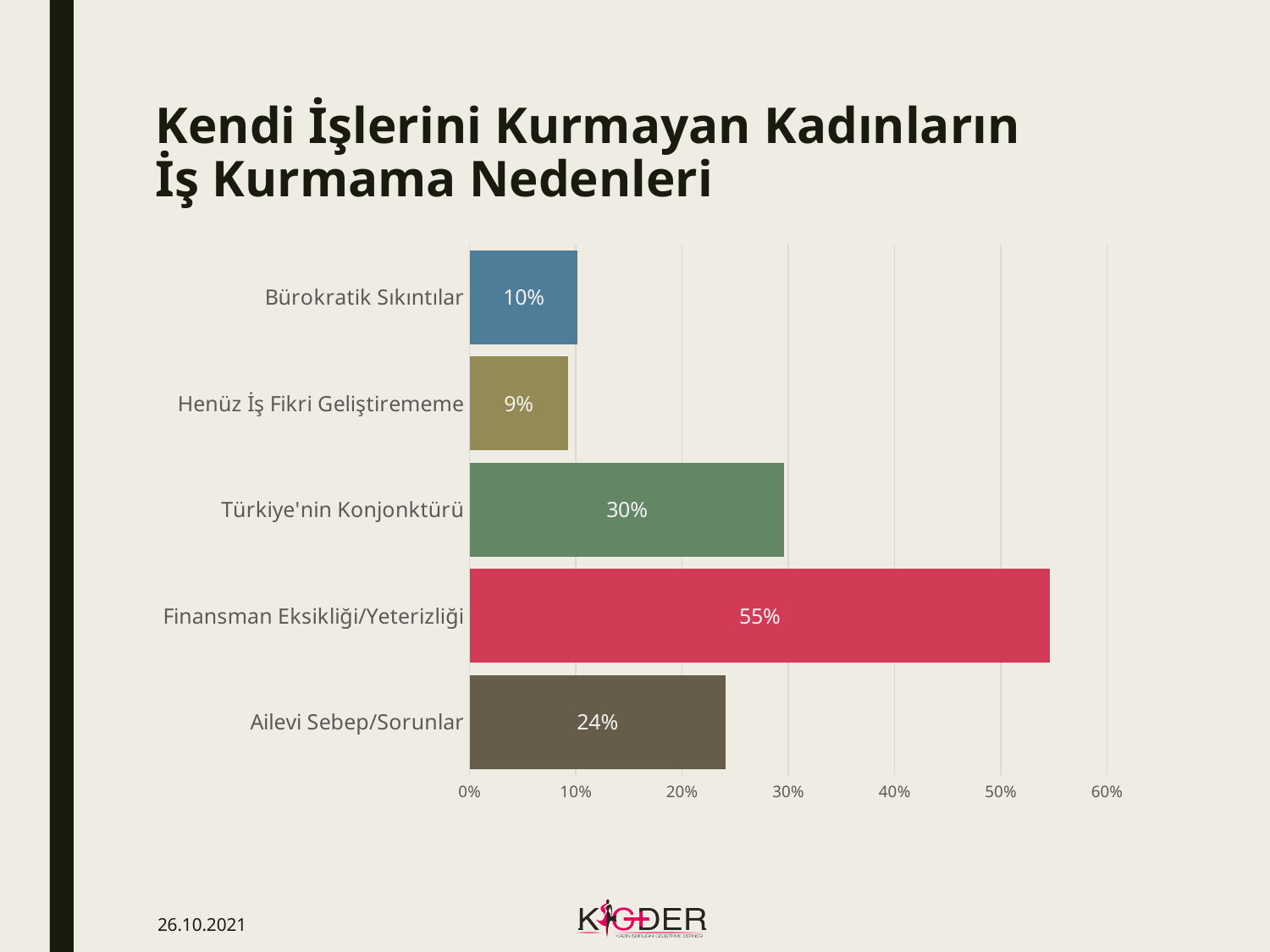
What is the difference between the values for Ailevi Sebep/Sorunlar and Bürokratik Sıkıntılar? 14% Which category has the lowest value? Henüz İş Fikri Geliştirememe Is the value for Finansman Eksikliği/Yeterizliği greater or less than 50%? greater How many categories are shown in the chart? 5 Which is larger, the value for Türkiye'nin Konjonktürü or the value for Ailevi Sebep/Sorunlar? Türkiye'nin Konjonktürü What is the title of the chart on the slide? Kendi İşlerini Kurmayan Kadınların İş Kurmama Nedenleri Which category has the highest value? Finansman Eksikliği/Yeterizliği What is the value for Ailevi Sebep/Sorunlar? 24% What is the difference between the values for Finansman Eksikliği/Yeterizliği and Türkiye'nin Konjonktürü? 25% What is the value for Henüz İş Fikri Geliştirememe? 9% What kind of chart is shown on the slide? bar chart What is the value for Finansman Eksikliği/Yeterizliği? 55%